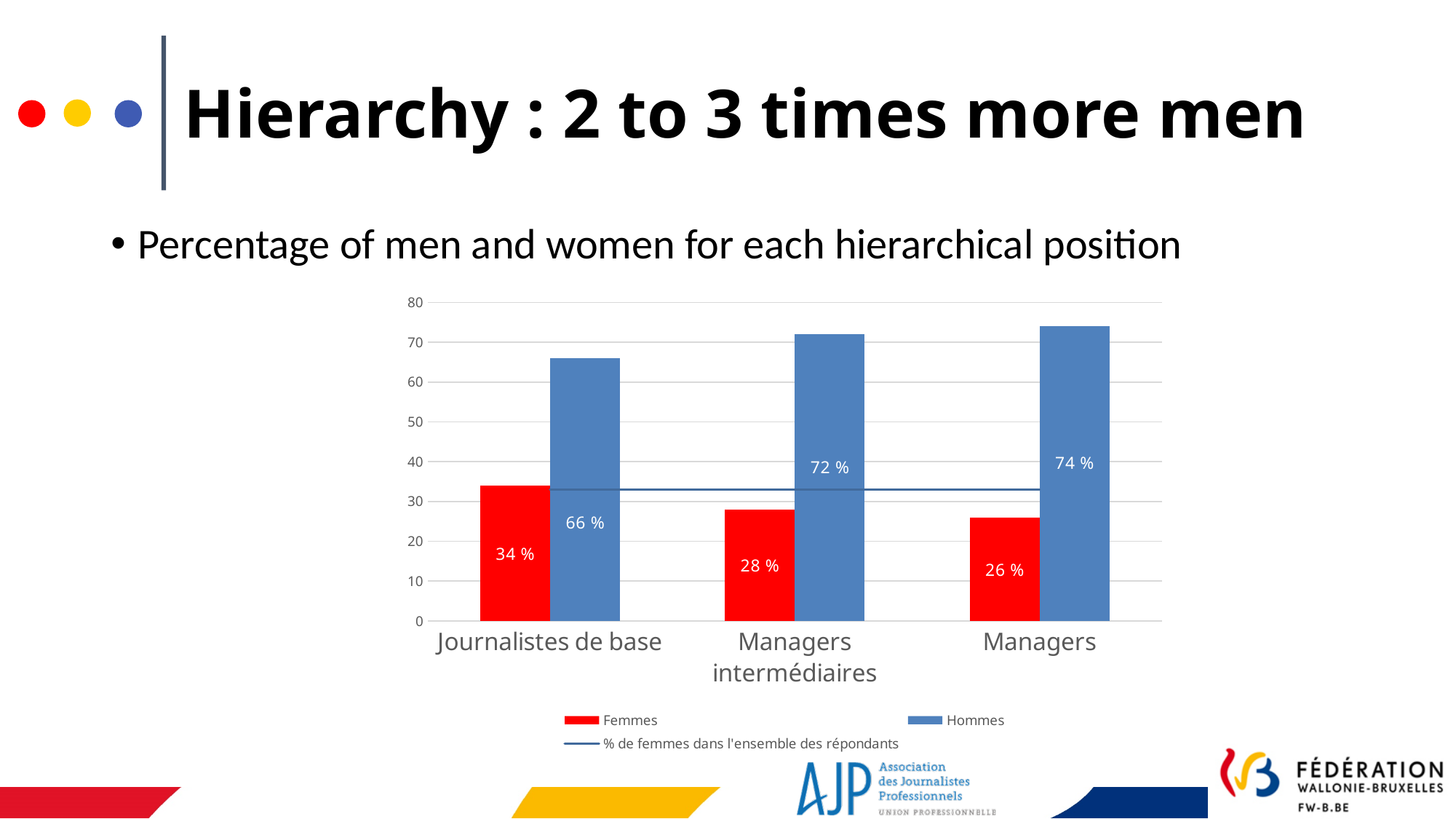
What is the value for Femmes in the Journalistes de base category? 34 % What is the difference between the Hommes and Femmes values in the Managers intermédiaires category? 44 % Which category has the highest value for Hommes? Managers How many series does the legend list? 3 Which category has the lowest value for Femmes? Managers Do the Femmes values rise or fall from Journalistes de base to Managers? fall How many categories are shown on the x axis? 3 Which is larger: the Femmes value for Journalistes de base or the Femmes value for Managers intermédiaires? Journalistes de base What is the value for Hommes in the Managers category? 74 % What is the value for Femmes in the Managers category? 26 % Is the value of the line '% de femmes dans l'ensemble des répondants' greater or less than 40? less What is the value for Hommes in the Managers intermédiaires category? 72 %